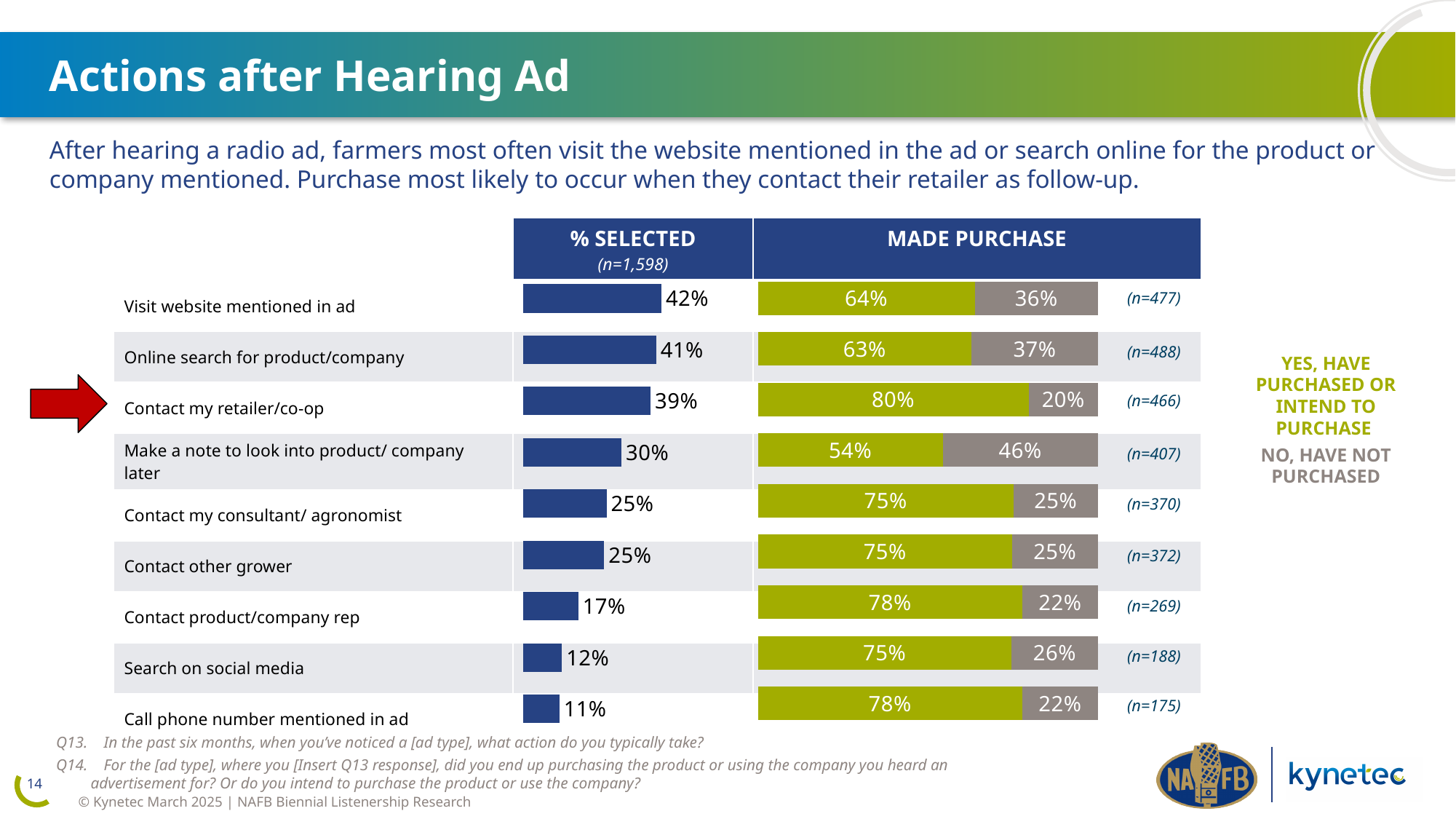
In the MADE PURCHASE chart, which action has the highest "Yes, have purchased or intend to purchase" share? Contact my retailer/co-op What kind of chart is the MADE PURCHASE chart? Stacked bar chart In the MADE PURCHASE chart, what is the "No, have not purchased" share for "Make a note to look into product/ company later"? 46% In the MADE PURCHASE chart, what is the sample size (n) shown for "Contact my consultant/ agronomist"? n=370 In the % SELECTED chart, what is the difference between "Visit website mentioned in ad" and "Search on social media"? 30% In the MADE PURCHASE chart, which is larger: the purchase share for "Contact product/company rep" or for "Online search for product/company"? Contact product/company rep In the % SELECTED chart, which action has the highest percentage? Visit website mentioned in ad In the % SELECTED chart, which action has the lowest percentage? Call phone number mentioned in ad How many actions are listed in the % SELECTED chart? 9 In the % SELECTED chart, what percentage of farmers selected "Visit website mentioned in ad"? 42% In the % SELECTED chart, what is the value for "Contact my retailer/co-op"? 39% In the MADE PURCHASE chart, what share of farmers who contacted their retailer/co-op have purchased or intend to purchase? 80%